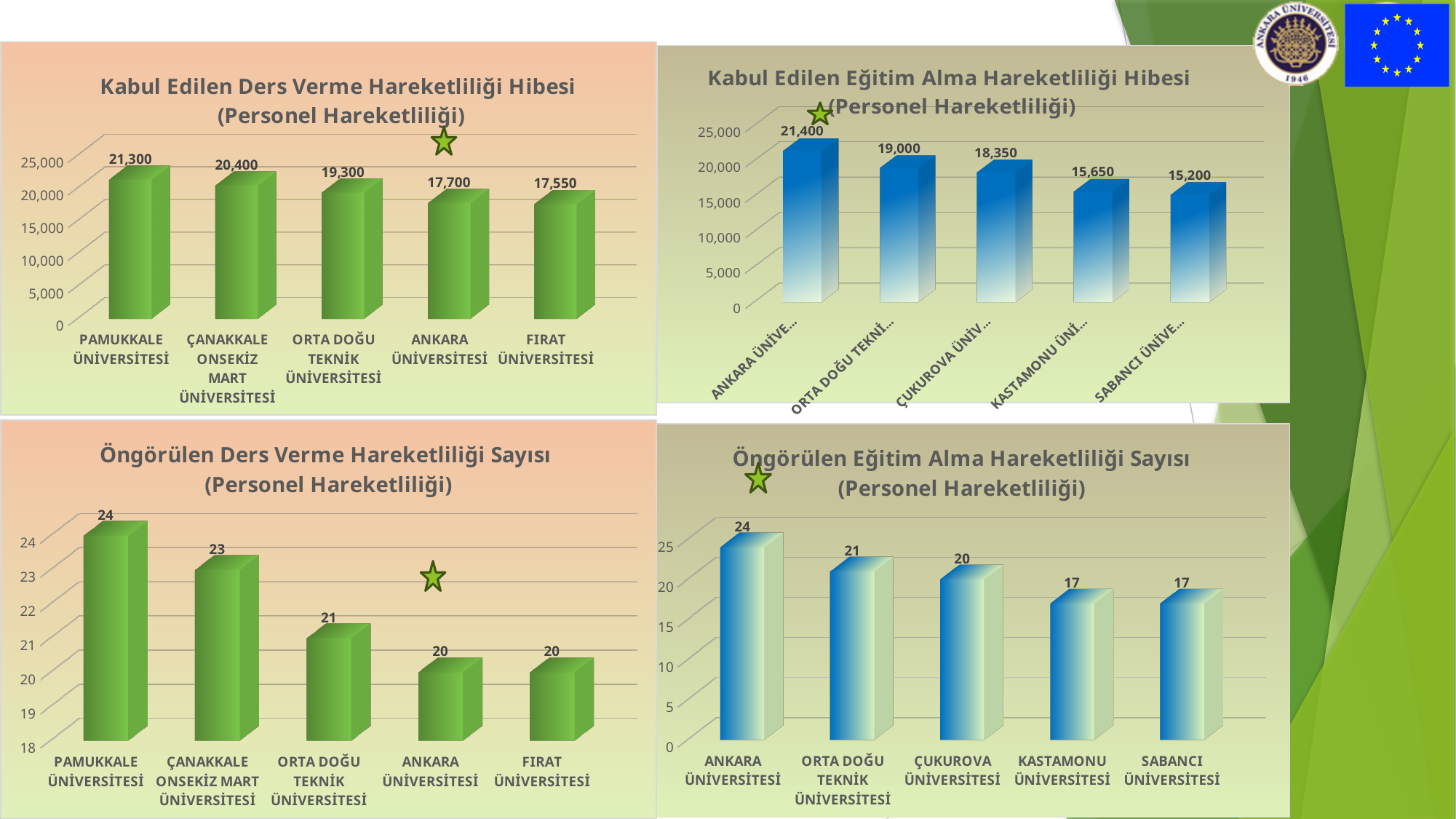
In the 'Öngörülen Eğitim Alma Hareketliliği Sayısı' chart (bottom right), what is the value for Kastamonu Üniversitesi? 17 In the 'Öngörülen Ders Verme Hareketliliği Sayısı' chart (bottom left), do the values rise or fall from left to right? fall In the 'Kabul Edilen Eğitim Alma Hareketliliği Hibesi' chart (top right), how many universities are shown? 5 In the 'Öngörülen Ders Verme Hareketliliği Sayısı' chart (bottom left), which is larger: Pamukkale Üniversitesi or Çanakkale Onsekiz Mart Üniversitesi? Pamukkale Üniversitesi In the 'Kabul Edilen Ders Verme Hareketliliği Hibesi' chart (top left), what is the value for Pamukkale Üniversitesi? 21,300 In the 'Kabul Edilen Ders Verme Hareketliliği Hibesi' chart (top left), which university has the lowest value? Fırat Üniversitesi In the 'Kabul Edilen Ders Verme Hareketliliği Hibesi' chart (top left), what is the difference between Çanakkale Onsekiz Mart Üniversitesi and Ankara Üniversitesi? 2,700 In the 'Kabul Edilen Eğitim Alma Hareketliliği Hibesi' chart (top right), which university has the highest value? Ankara Üniversitesi In the 'Öngörülen Eğitim Alma Hareketliliği Sayısı' chart (bottom right), what is the difference between Ankara Üniversitesi and Sabancı Üniversitesi? 7 What type of chart is the 'Öngörülen Eğitim Alma Hareketliliği Sayısı' chart (bottom right)? bar chart In the 'Öngörülen Ders Verme Hareketliliği Sayısı' chart (bottom left), what is the value for Orta Doğu Teknik Üniversitesi? 21 In the 'Kabul Edilen Eğitim Alma Hareketliliği Hibesi' chart (top right), what is the value for Çukurova Üniversitesi? 18,350